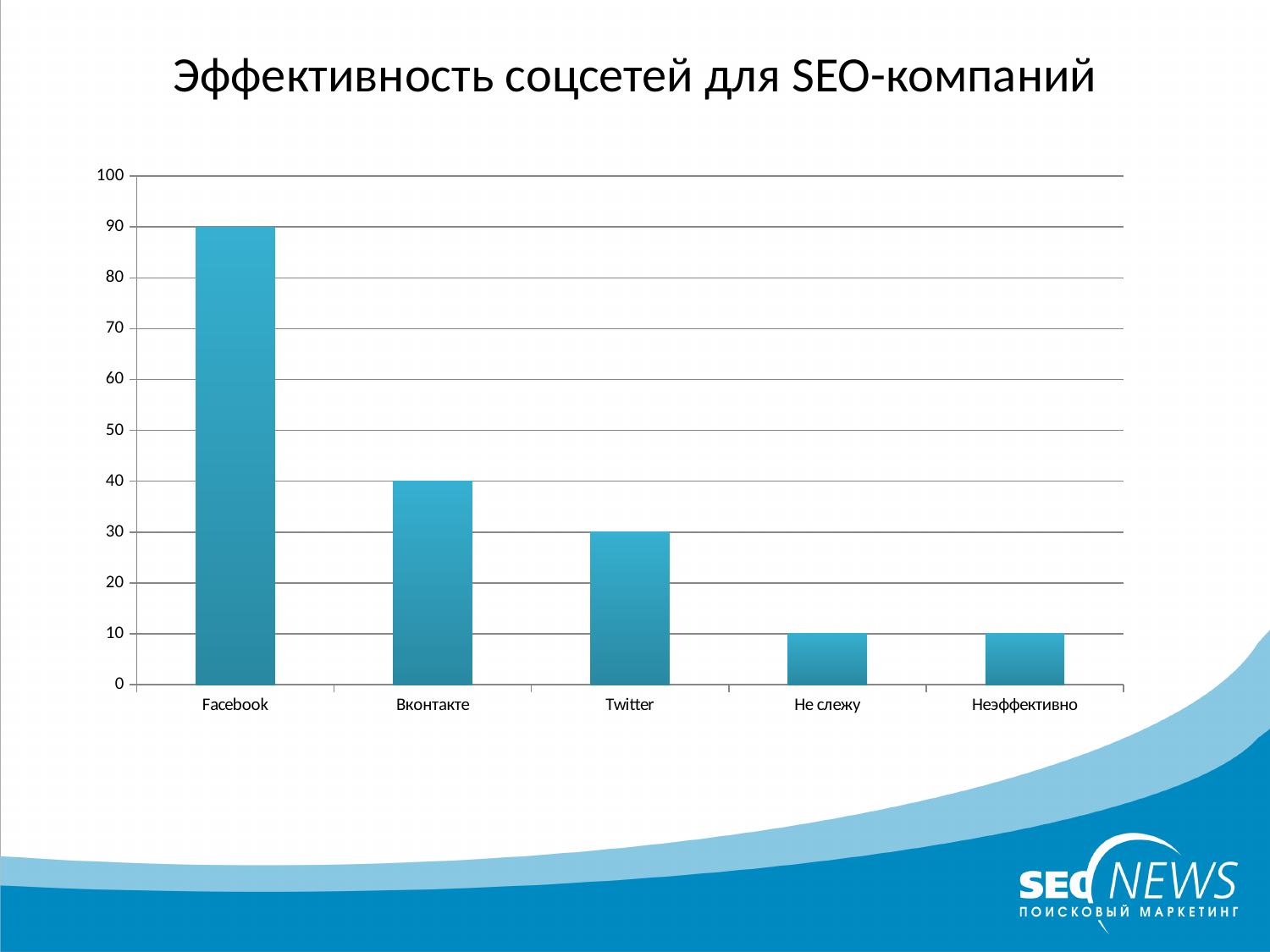
What is the value for Не слежу? 10 How many categories are shown on the x axis? 5 What is the difference between the values for Twitter and Неэффективно? 20 Which is larger, the value for Вконтакте or the value for Twitter? Вконтакте What kind of chart is shown on the slide? bar chart Which category has the highest value? Facebook What is the title of the slide? Эффективность соцсетей для SEO-компаний What is the value for Facebook? 90 What is the value for Вконтакте? 40 Is the value for Facebook greater or less than 50? greater What is the value for Twitter? 30 What is the difference between the values for Facebook and Вконтакте? 50